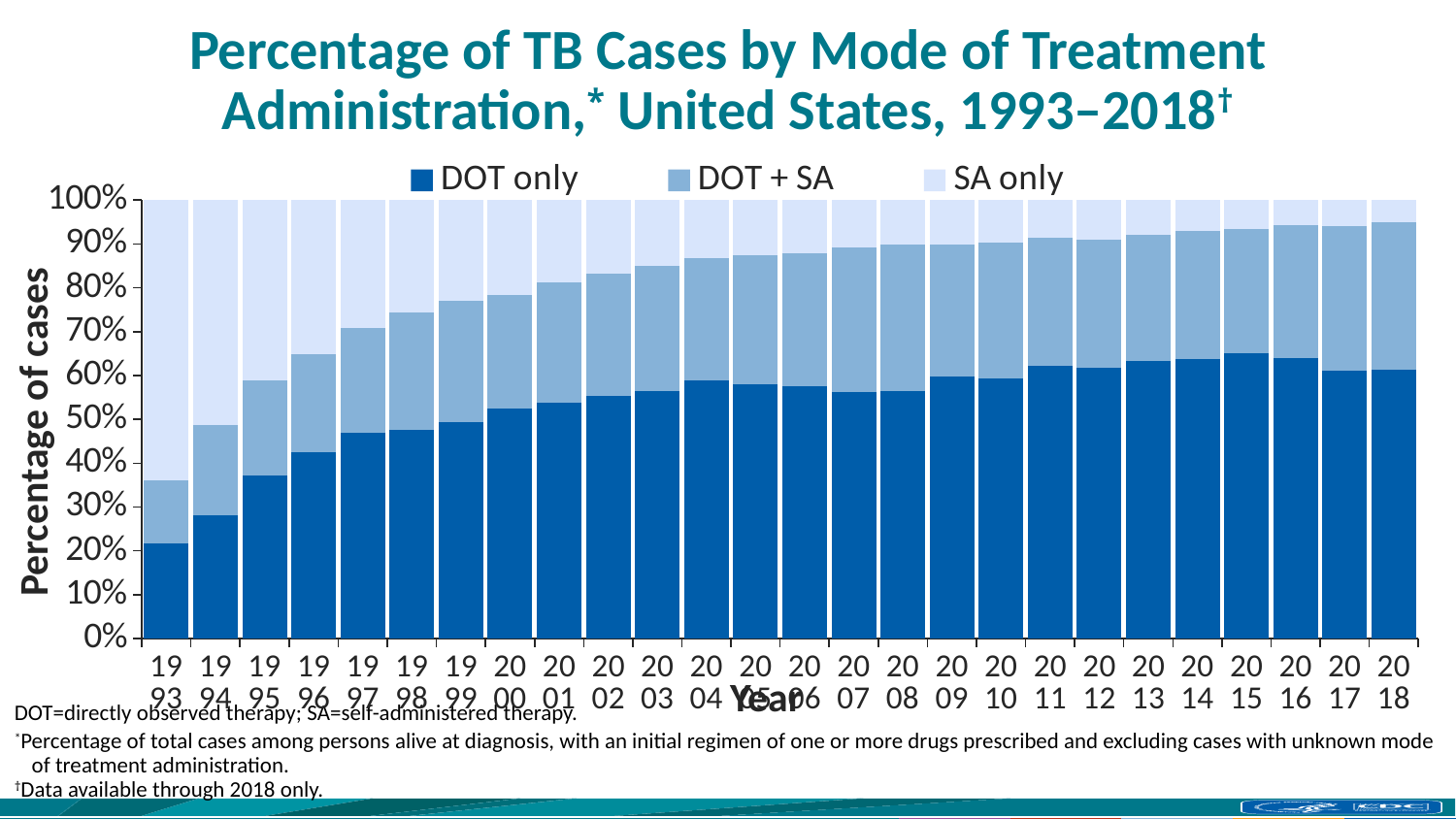
Is the SA only share in 2018 greater or less than 10%? less What kind of chart is shown on the slide? stacked bar chart What is the label on the y axis? Percentage of cases Is the DOT only share in 1993 greater or less than 30%? less In which year is the DOT only share lowest? 1993 How many years are plotted along the x axis? 26 Does the share of DOT only cases rise or fall from 1993 to 2018? rise What does each stacked bar total? 100% How many series does the legend list? 3 Is the SA only share in 1993 greater or less than 50%? greater Which year has the larger DOT only share, 1993 or 2018? 2018